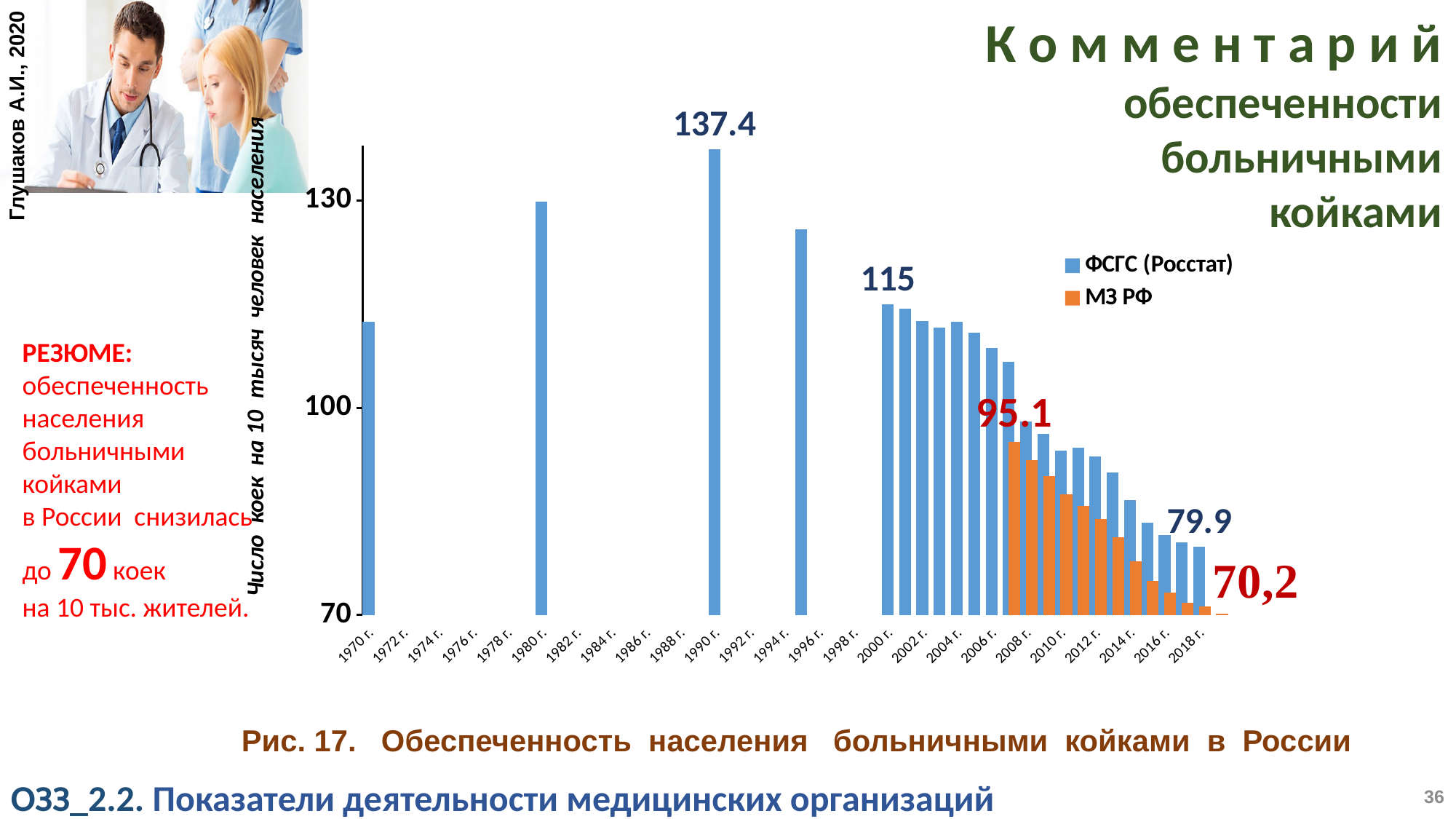
Is the ФСГС (Росстат) value for 1980 г. greater or less than 100? greater Which is larger, the value for 1990 г. or the value for 2000 г.? 1990 г. From 2000 г. onward, do the bar values rise or fall along the x axis? fall Is the ФСГС (Росстат) value for 2016 г. greater or less than 100? less What is the ФСГС (Росстат) value for 1990 г.? 137.4 Which year has the highest bar on the chart? 1990 г. What is the difference between the labelled values for 1990 г. and 2000 г.? 22.4 How many series does the chart legend list? 2 What are the two series named in the chart legend? ФСГС (Росстат) and МЗ РФ What is the ФСГС (Росстат) value for 2000 г.? 115 What kind of chart is shown on the slide? bar chart